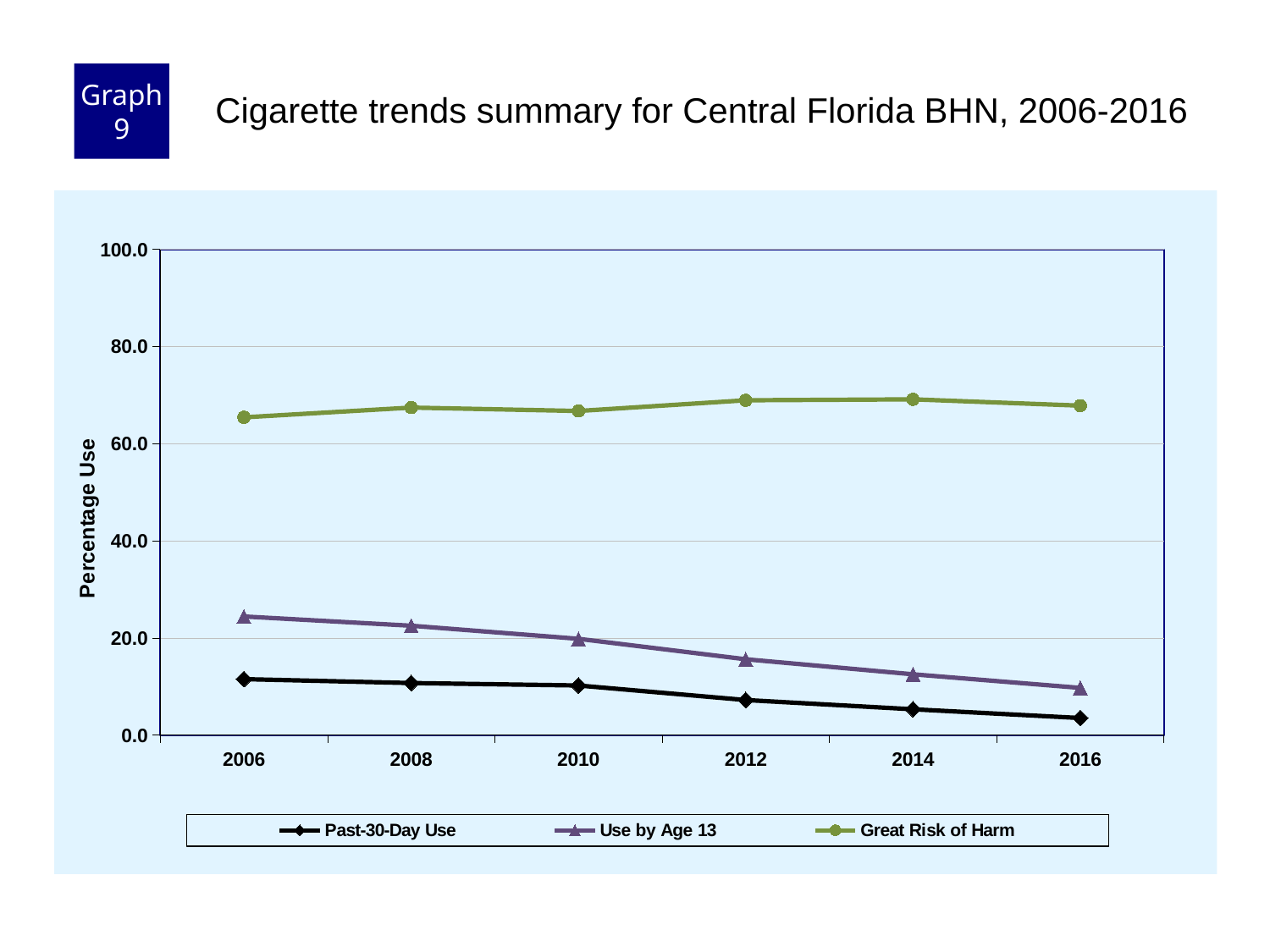
How many years are plotted along the x axis? 6 Is the value for Use by Age 13 in 2006 greater or less than 20.0? greater Is the value for Great Risk of Harm in 2006 greater or less than 60.0? greater How many series does the legend list? 3 What kind of chart is shown on the slide? Line chart Which series has the highest values across all years? Great Risk of Harm Does the Past-30-Day Use series rise or fall from 2006 to 2016? Fall Is the value for Use by Age 13 in 2016 greater or less than 20.0? less Which series has the lowest values across all years? Past-30-Day Use In 2012, which is larger: Use by Age 13 or Past-30-Day Use? Use by Age 13 What is the label on the y axis? Percentage Use